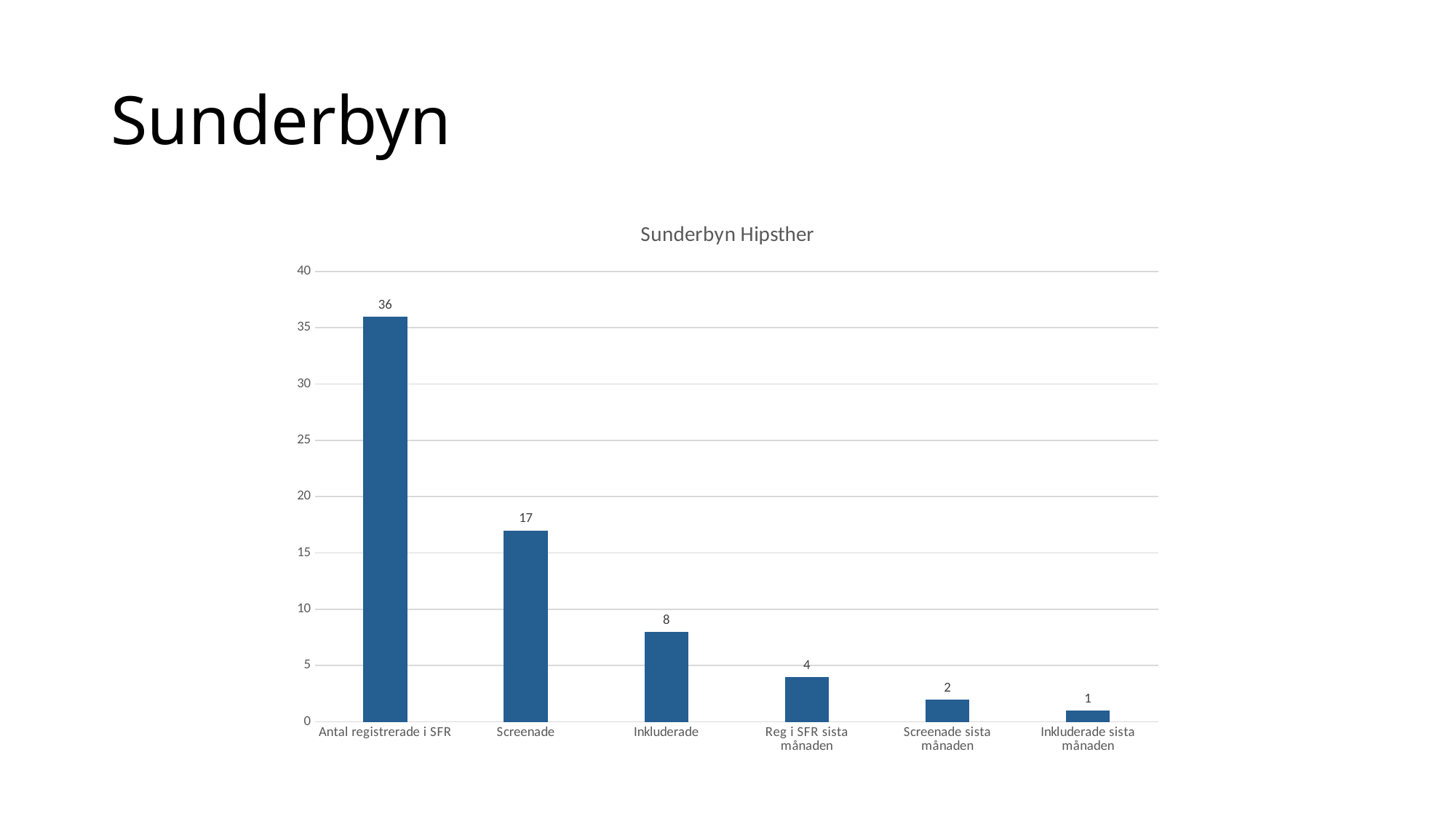
What is the title of the chart? Sunderbyn Hipsther Which is larger, the value for Inkluderade or the value for Screenade sista månaden? Inkluderade What is the value for Inkluderade? 8 What is the value for Inkluderade sista månaden? 1 What is the difference between the values for Antal registrerade i SFR and Screenade? 19 Which category has the highest value? Antal registrerade i SFR Which category has the lowest value? Inkluderade sista månaden What is the value for Antal registrerade i SFR? 36 What kind of chart is shown on the slide? Bar chart What is the value for Reg i SFR sista månaden? 4 What is the value for Screenade? 17 How many categories are shown on the x axis? 6